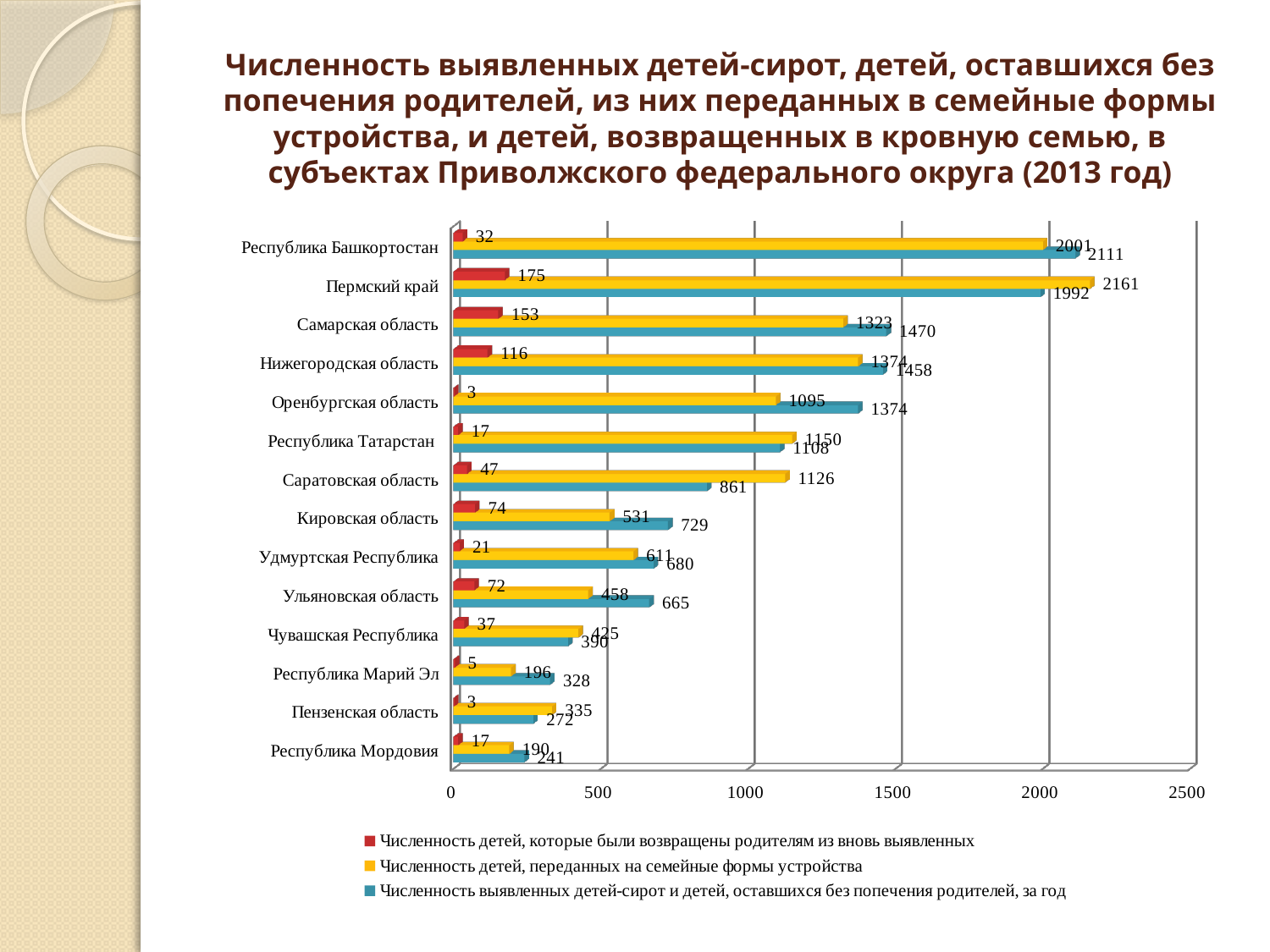
How many series does the legend list? 3 What kind of chart is shown on the slide? Bar chart For Саратовская область, which is larger: 'Численность детей, переданных на семейные формы устройства' or 'Численность выявленных детей-сирот и детей, оставшихся без попечения родителей, за год'? Численность детей, переданных на семейные формы устройства What is the value of 'Численность выявленных детей-сирот и детей, оставшихся без попечения родителей, за год' for Республика Башкортостан? 2111 Which region has the highest value for 'Численность детей, которые были возвращены родителям из вновь выявленных'? Пермский край How many regions (categories) are plotted on the chart? 14 For Кировская область, what is the difference between 'Численность выявленных детей-сирот и детей, оставшихся без попечения родителей, за год' and 'Численность детей, переданных на семейные формы устройства'? 198 What is the value of 'Численность детей, которые были возвращены родителям из вновь выявленных' for Пермский край? 175 Which region has the lowest value for 'Численность выявленных детей-сирот и детей, оставшихся без попечения родителей, за год'? Республика Мордовия What is the value of 'Численность детей, переданных на семейные формы устройства' for Самарская область? 1323 Is the value of 'Численность выявленных детей-сирот и детей, оставшихся без попечения родителей, за год' for Ульяновская область greater or less than 1000? less Which colour represents 'Численность детей, которые были возвращены родителям из вновь выявленных' in the legend? Red